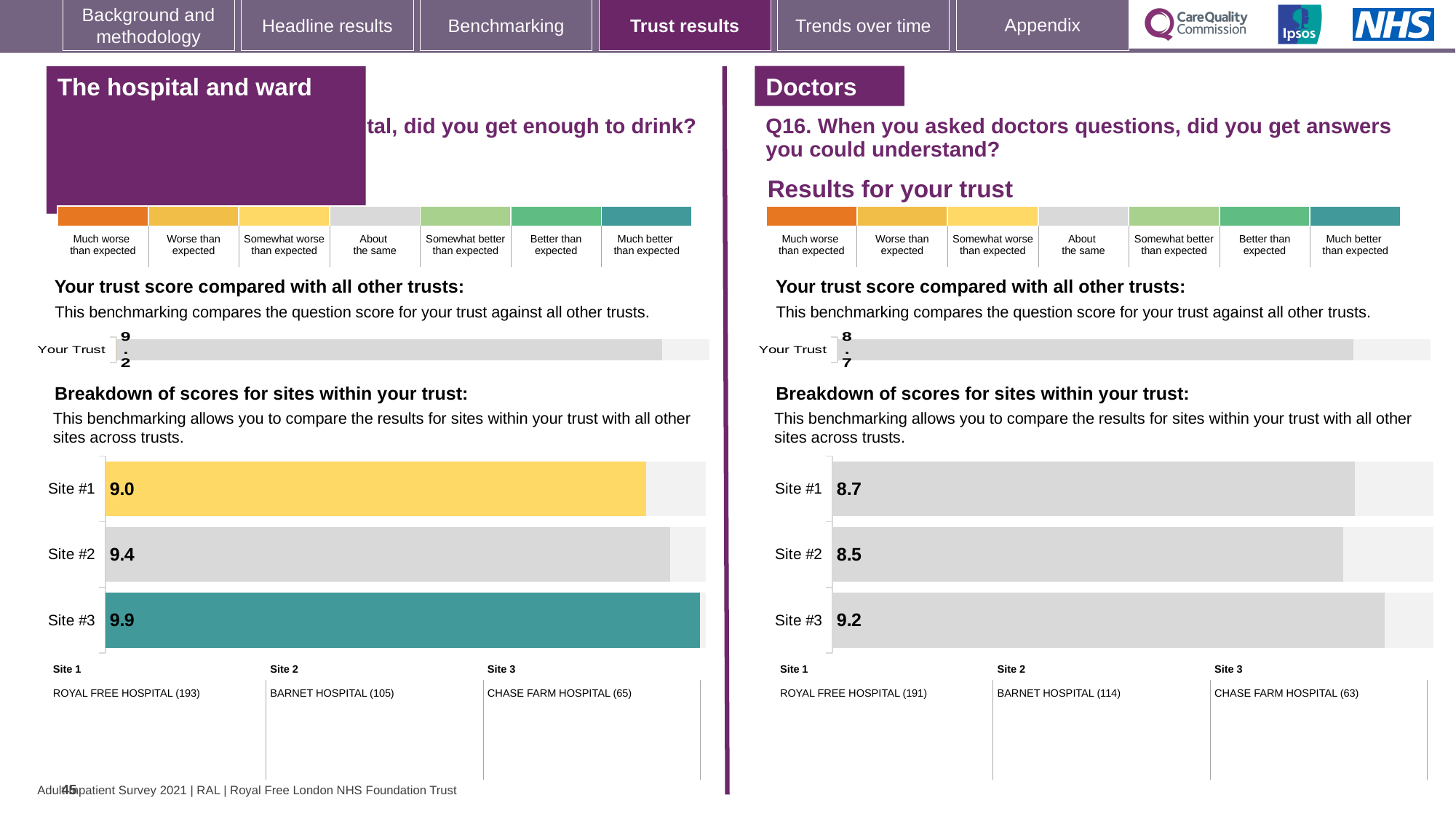
How many sites are shown on the left-hand site breakdown chart? 3 On the left-hand site breakdown chart, what is the difference between the scores for Site #3 and Site #1? 0.9 What kind of chart is the left-hand 'Breakdown of scores for sites within your trust' chart? Bar chart On the left-hand 'Breakdown of scores for sites within your trust' chart, what is the score for Site #3? 9.9 On the right-hand (Doctors, Q16) 'Breakdown of scores for sites within your trust' chart, what is the score for Site #2? 8.5 On the left-hand site breakdown chart, which site has the highest score? Site #3 On the right-hand (Doctors, Q16) site breakdown chart, which site has the lowest score? Site #2 On the right-hand (Doctors, Q16) 'Your trust score compared with all other trusts' chart, what is the score shown for Your Trust? 8.7 On the left-hand site breakdown chart, do the scores rise or fall from Site #1 to Site #3? Rise On the right-hand (Doctors, Q16) site breakdown chart, which has the larger score, Site #1 or Site #3? Site #3 On the left-hand 'Your trust score compared with all other trusts' chart, what is the score shown for Your Trust? 9.2 On the right-hand (Doctors, Q16) site breakdown chart, what is the difference between the scores for Site #3 and Site #2? 0.7